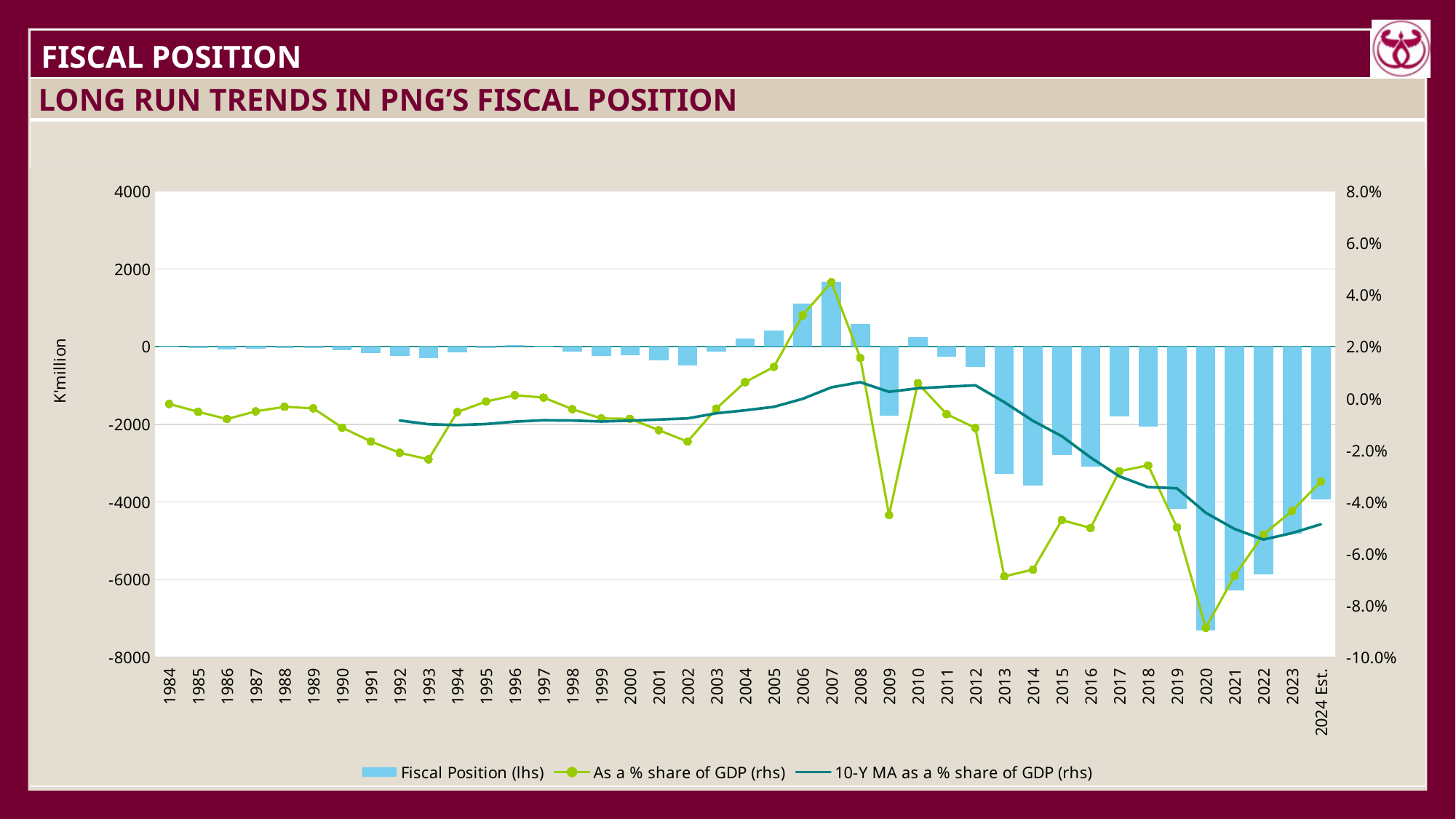
In which year does the 'As a % share of GDP (rhs)' line reach its lowest point? 2020 What is the label on the left vertical axis? K'million Is the Fiscal Position (lhs) value for 2007 greater or less than 1000? greater Do the Fiscal Position (lhs) bars rise or fall from 2013 to 2020? fall How many series does the legend list? 3 Which year has the lower Fiscal Position (lhs) value, 2020 or 2022? 2020 What kind of chart is shown on the slide? combination bar and line chart In which year is the Fiscal Position (lhs) bar highest? 2007 Which year has the larger Fiscal Position (lhs) bar, 2006 or 2007? 2007 In which year is the Fiscal Position (lhs) bar lowest? 2020 Is the Fiscal Position (lhs) value for 2020 greater or less than -6000? less Is the 'As a % share of GDP (rhs)' value for 2013 greater or less than -6.0%? less